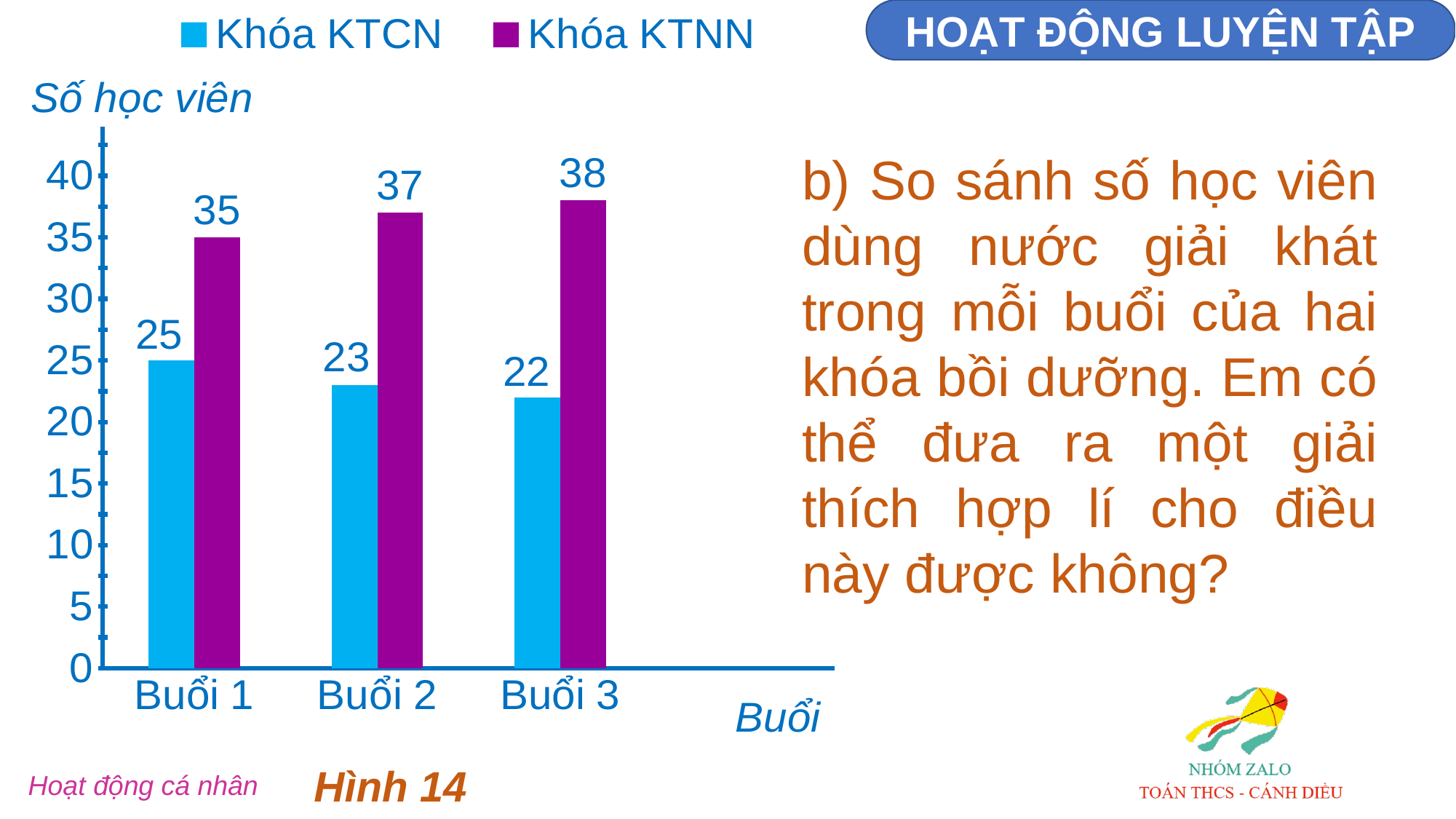
What is the difference between Khóa KTNN and Khóa KTCN in Buổi 1? 10 What kind of chart is shown? Bar chart What is the value for Khóa KTCN in Buổi 1? 25 What is the value for Khóa KTNN in Buổi 2? 37 What is the difference between Khóa KTNN and Khóa KTCN in Buổi 3? 16 Do the Khóa KTCN values rise or fall from Buổi 1 to Buổi 3? Fall How many series does the legend list? 2 In which session (Buổi) is the Khóa KTNN value highest? Buổi 3 Which is larger in Buổi 2: Khóa KTCN or Khóa KTNN? Khóa KTNN How many sessions (categories) are shown on the x axis? 3 In which session (Buổi) is the Khóa KTCN value lowest? Buổi 3 What is the value for Khóa KTNN in Buổi 3? 38